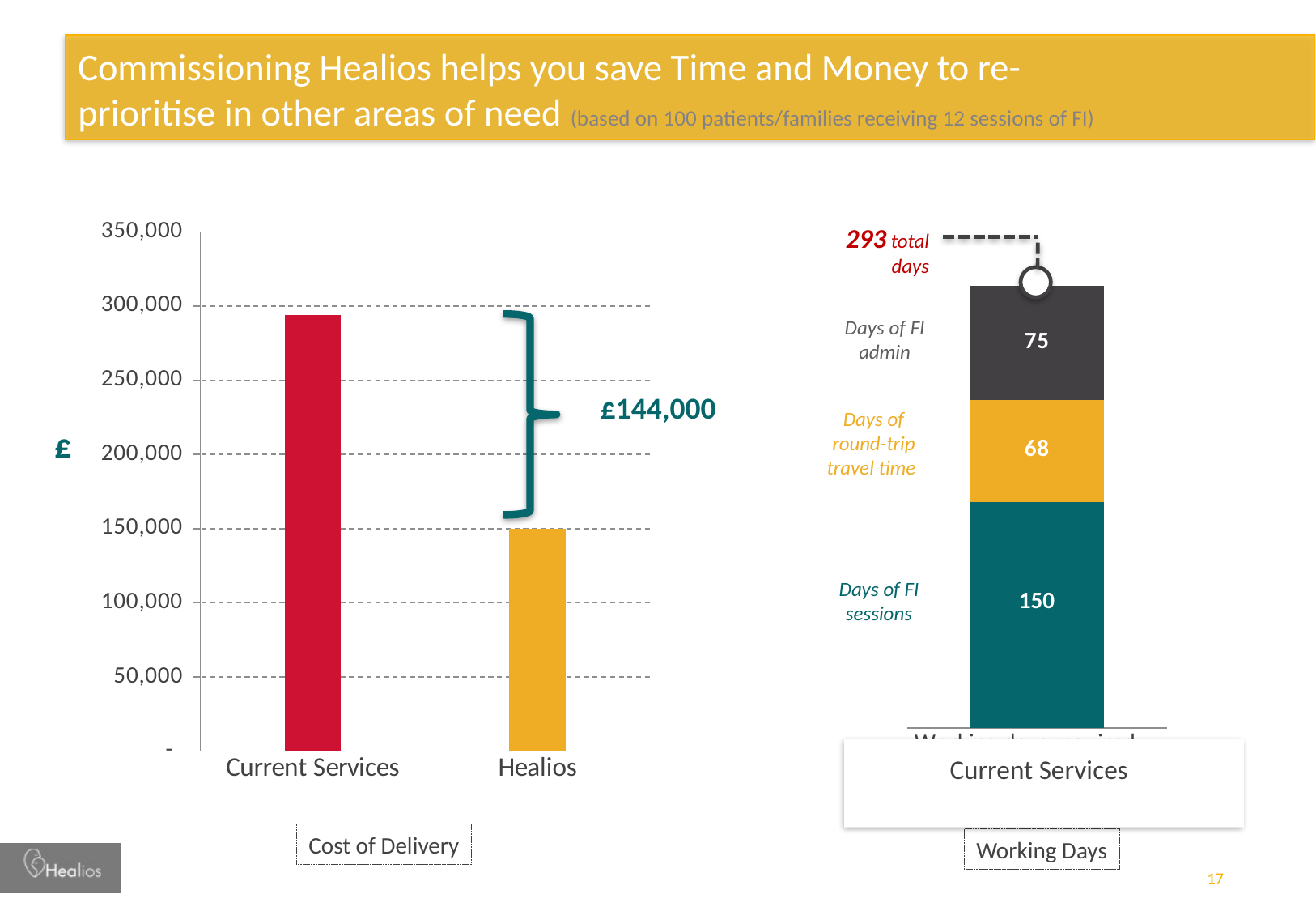
On the Cost of Delivery chart, what saving is annotated between the Current Services and Healios bars? £144,000 On the Cost of Delivery chart, is the value for Healios greater or less than 200,000? less On the Working Days chart, how many days of round-trip travel time are shown? 68 On the Cost of Delivery chart, is the value for Current Services greater or less than 250,000? greater On the Cost of Delivery chart, how many categories are shown on the x axis? 2 On the Working Days chart, what is the difference between days of FI admin and days of round-trip travel time? 7 On the Working Days chart, how many days of FI sessions are shown for Current Services? 150 What kind of chart is the Cost of Delivery chart? bar chart On the Working Days chart, how many days of FI admin are shown? 75 On the Working Days chart, which segment is the largest? Days of FI sessions On the Cost of Delivery chart, which category has the higher cost, Current Services or Healios? Current Services On the Working Days chart, what is the total number of working days for Current Services? 293